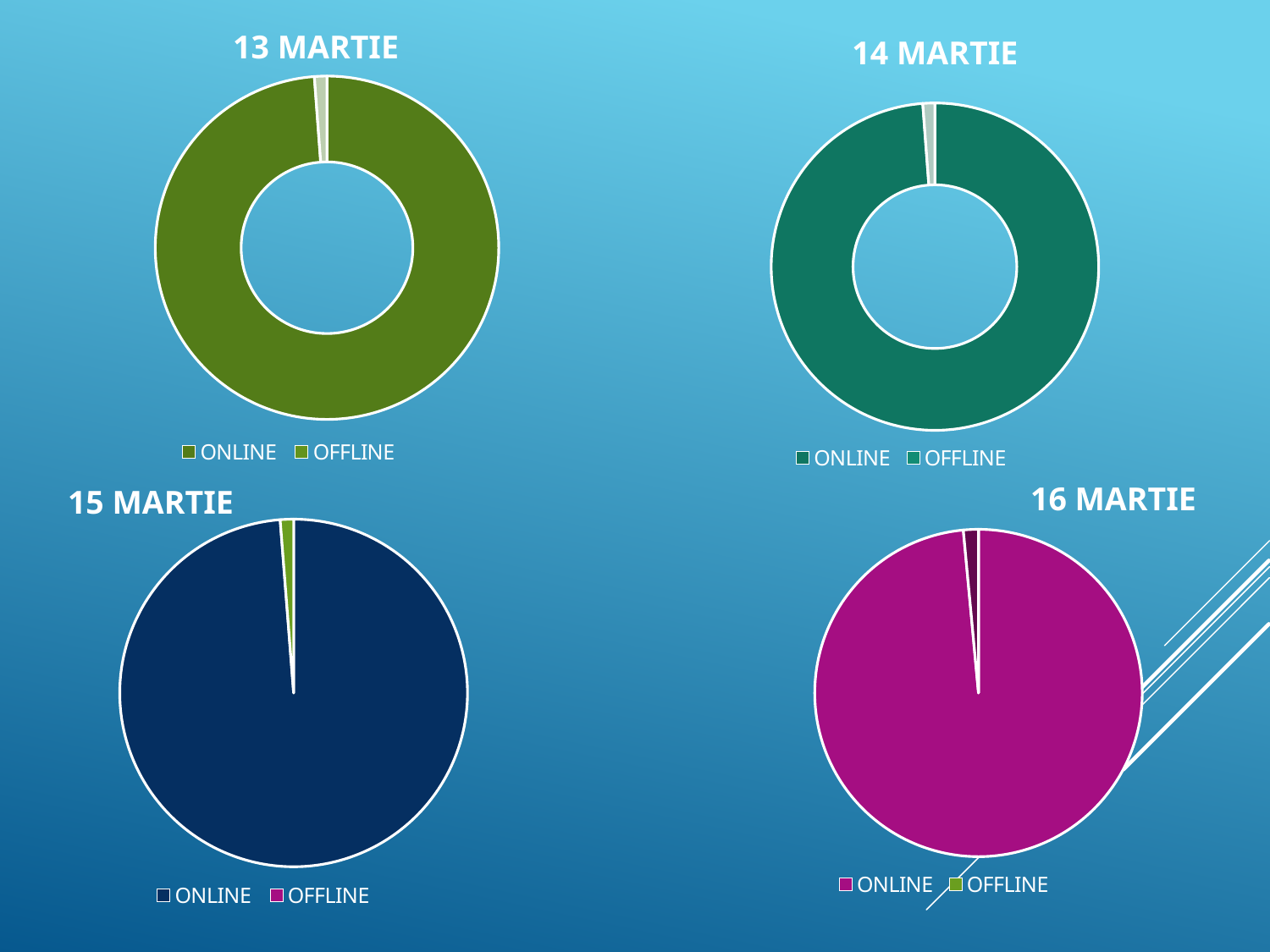
What is the title of the chart in the bottom-left of the slide? 15 MARTIE In the "14 MARTIE" chart, which is larger, OFFLINE or ONLINE? ONLINE What are the two legend entries in the "16 MARTIE" chart? ONLINE and OFFLINE What kind of chart is the "13 MARTIE" chart? Doughnut chart In the "15 MARTIE" chart, which category has the smallest share? OFFLINE In the "14 MARTIE" chart, which category has the smallest share? OFFLINE How many charts are shown on the slide? 4 In the "15 MARTIE" chart, which is larger, ONLINE or OFFLINE? ONLINE What kind of chart is the "15 MARTIE" chart? Pie chart In the "16 MARTIE" chart, which category has the largest share? ONLINE How many categories does the legend of the "14 MARTIE" chart list? 2 In the "13 MARTIE" chart, which category has the largest share? ONLINE